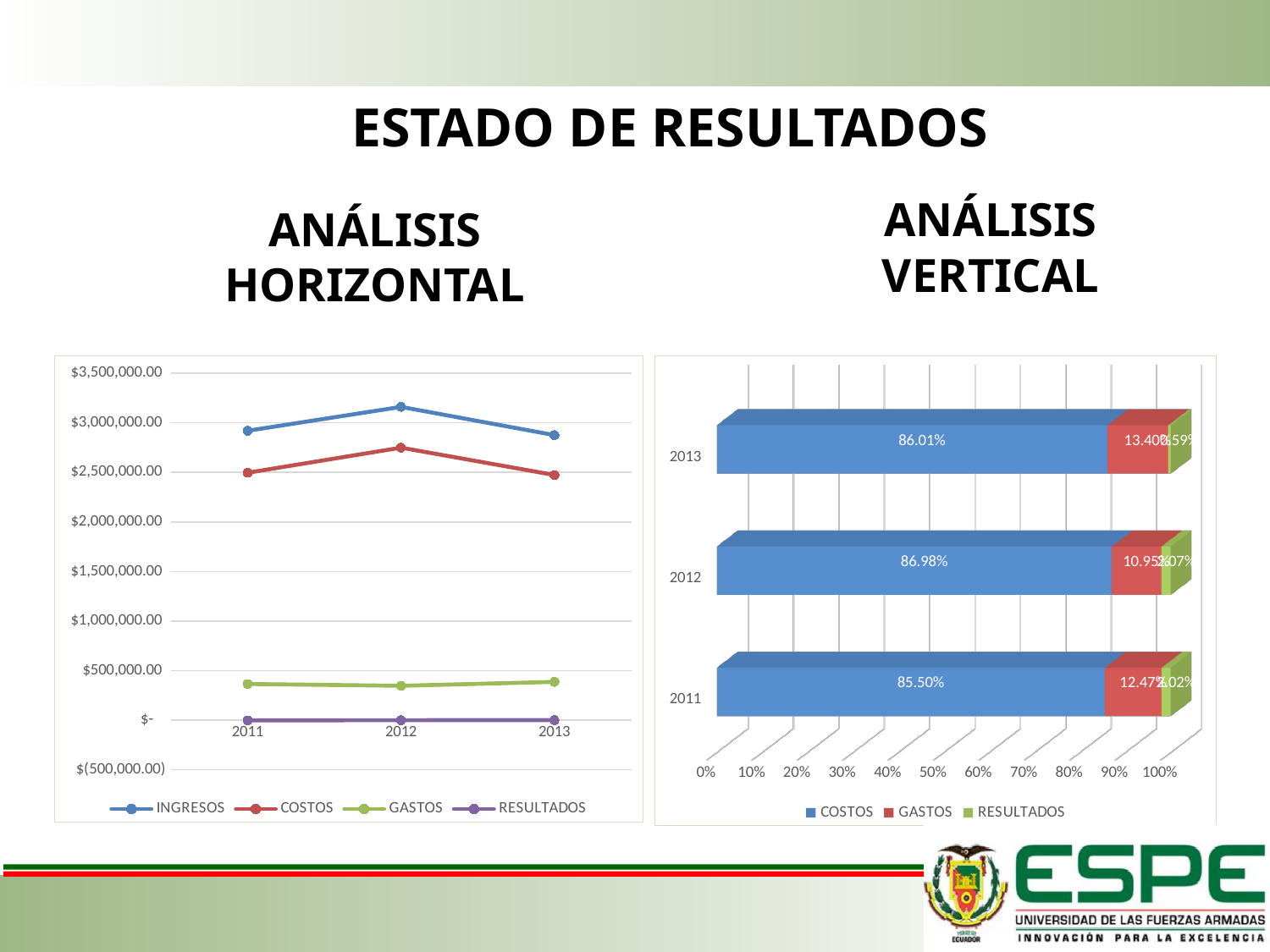
What kind of chart is the ANÁLISIS HORIZONTAL chart on the left? line chart In the ANÁLISIS VERTICAL chart, how many series does the legend list? 3 In the ANÁLISIS HORIZONTAL chart, is the INGRESOS value for 2012 greater or less than $3,000,000.00? greater In the ANÁLISIS HORIZONTAL chart, is the COSTOS value for 2012 greater or less than $2,500,000.00? greater In the ANÁLISIS HORIZONTAL chart, which is larger in 2013, INGRESOS or COSTOS? INGRESOS How many years are shown on the x axis of the ANÁLISIS HORIZONTAL chart? 3 In the ANÁLISIS VERTICAL chart, what is the GASTOS share for 2011? 12.47% In the ANÁLISIS VERTICAL chart, in which year is the COSTOS share highest? 2012 What kind of chart is the ANÁLISIS VERTICAL chart on the right? bar chart In the ANÁLISIS HORIZONTAL chart, in which year is INGRESOS highest? 2012 How many series does the legend of the ANÁLISIS HORIZONTAL chart list? 4 In the ANÁLISIS VERTICAL chart, what is the COSTOS share for 2013? 86.01%